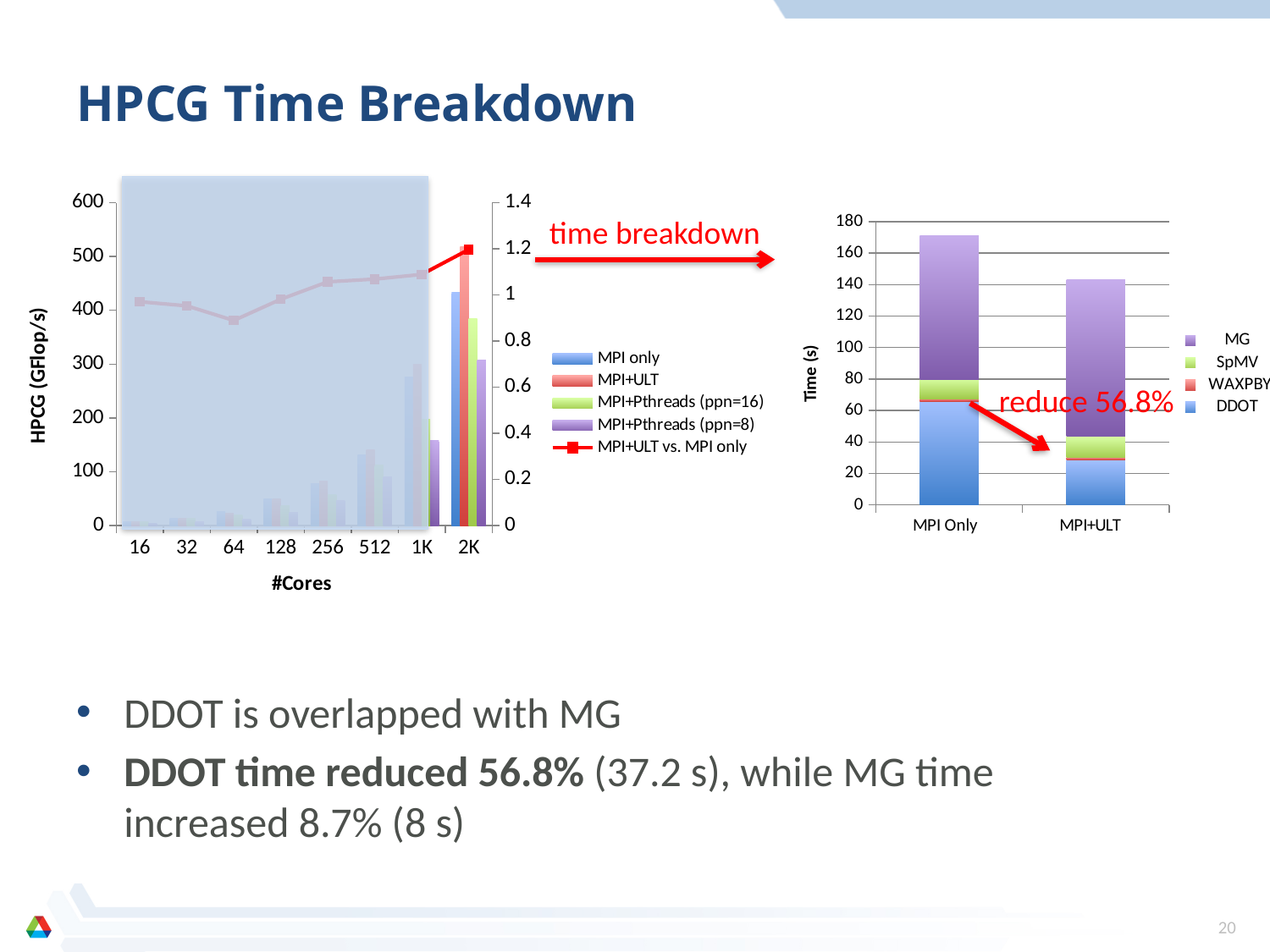
In the left-hand chart, is the MPI+ULT vs. MPI only line value at 2K cores greater or less than 1 on the right axis? greater How many categories are on the #Cores axis of the left-hand chart? 8 In the right-hand chart, is the DDOT segment for MPI+ULT greater or less than 40? less In the right-hand chart, is the total height of the MPI Only bar greater or less than 160? greater What kind of chart is the chart on the right of the slide? stacked bar chart How many series does the legend of the right-hand chart list? 4 In the left-hand chart, which series has the tallest bar at 2K cores? MPI+ULT How many categories are on the x axis of the right-hand chart? 2 What is the y-axis label of the right-hand chart? Time (s) In the right-hand chart, which category has the taller stacked bar, MPI Only or MPI+ULT? MPI Only How many entries does the legend of the left-hand chart list? 5